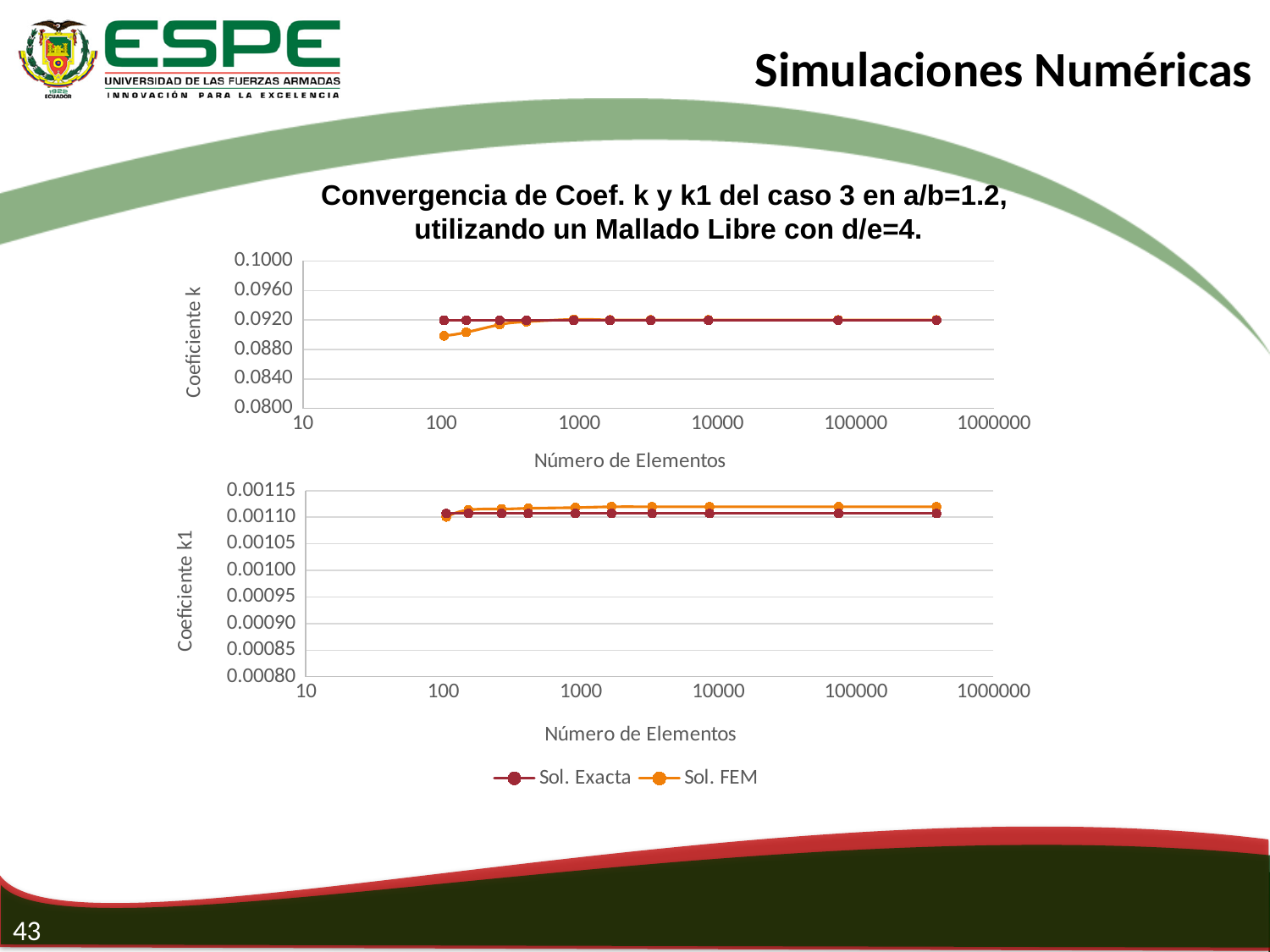
What are the two series named in the legend? Sol. Exacta and Sol. FEM In the bottom chart (Coeficiente k1), is the Sol. Exacta value at 100000 elements greater or less than 0.00115? less What kind of chart is the top chart (Coeficiente k)? Line chart What is the x-axis label of the bottom chart (Coeficiente k1)? Número de Elementos In the bottom chart (Coeficiente k1), at 10000 elements, which series has the higher value, Sol. Exacta or Sol. FEM? Sol. FEM In the top chart (Coeficiente k), at 100 elements, which series has the higher value, Sol. Exacta or Sol. FEM? Sol. Exacta In the top chart (Coeficiente k), does the Sol. FEM series rise or fall as the number of elements increases from 100 to 1000? rises How many series does the legend list? 2 In the top chart (Coeficiente k), is the Sol. FEM value at 100 elements greater or less than 0.0920? less In the top chart (Coeficiente k), is the Sol. Exacta value at 10000 elements greater or less than 0.0880? greater In the bottom chart (Coeficiente k1), does the Sol. FEM series rise or fall as the number of elements increases from 100 to 1000? rises